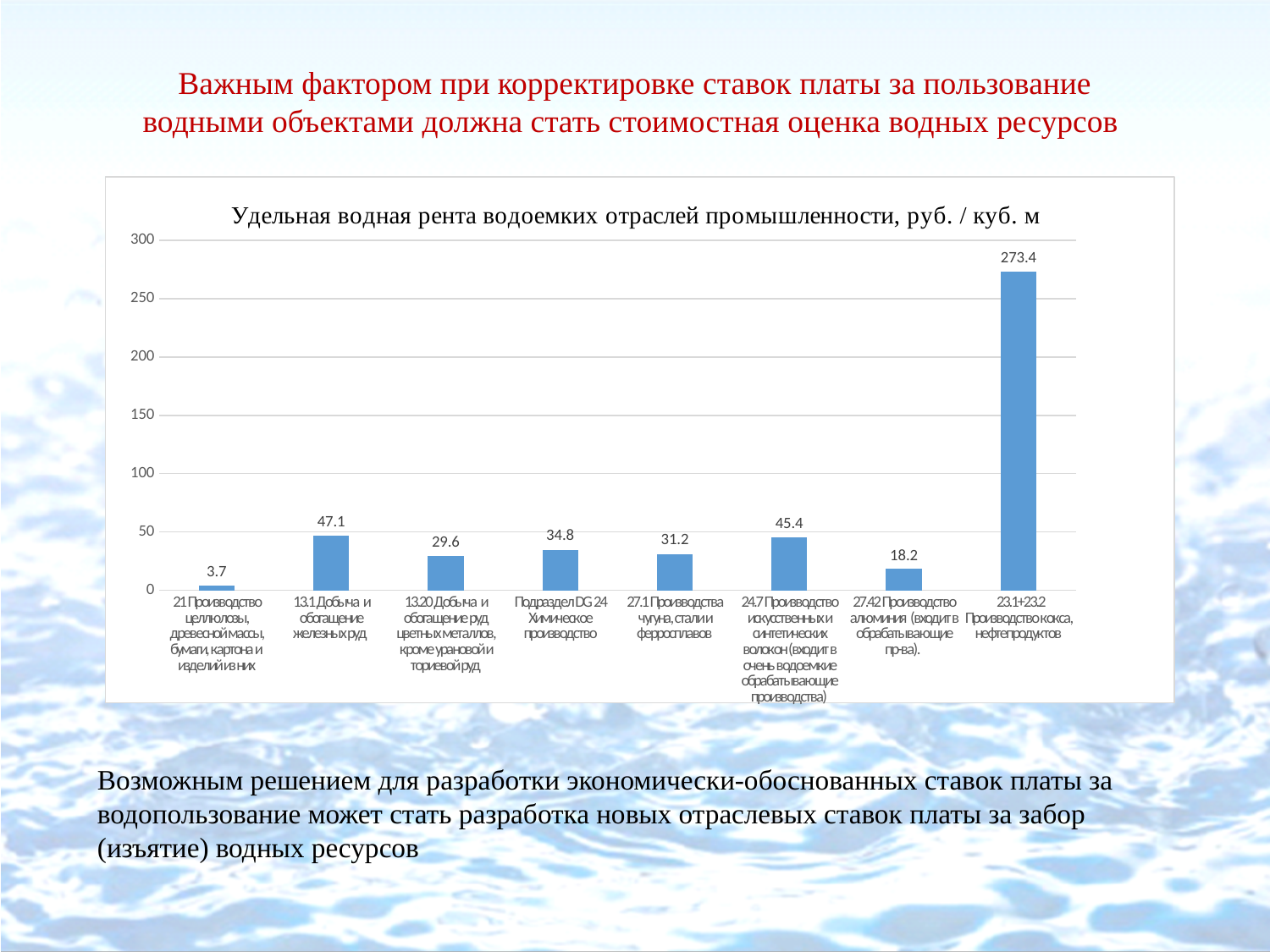
What is the value for 27.42 Производство алюминия? 18.2 What is the title of the chart? Удельная водная рента водоемких отраслей промышленности, руб. / куб. м What kind of chart is shown on the slide? bar chart Is the value for 23.1+23.2 Производство кокса, нефтепродуктов greater or less than 250? greater Which is larger, the value for 27.1 Производство чугуна, стали и ферросплавов or the value for 13.20 Добыча и обогащение руд цветных металлов? 27.1 Производство чугуна, стали и ферросплавов What is the value for 13.1 Добыча и обогащение железных руд? 47.1 Which category has the lowest value? 21 Производство целлюлозы, древесной массы, бумаги, картона и изделий из них What is the difference between the values for 13.1 Добыча и обогащение железных руд and 24.7 Производство искусственных и синтетических волокон? 1.7 Which category has the highest value? 23.1+23.2 Производство кокса, нефтепродуктов What is the value for 23.1+23.2 Производство кокса, нефтепродуктов? 273.4 How many categories are shown in the chart? 8 What is the value for Подраздел DG 24 Химическое производство? 34.8